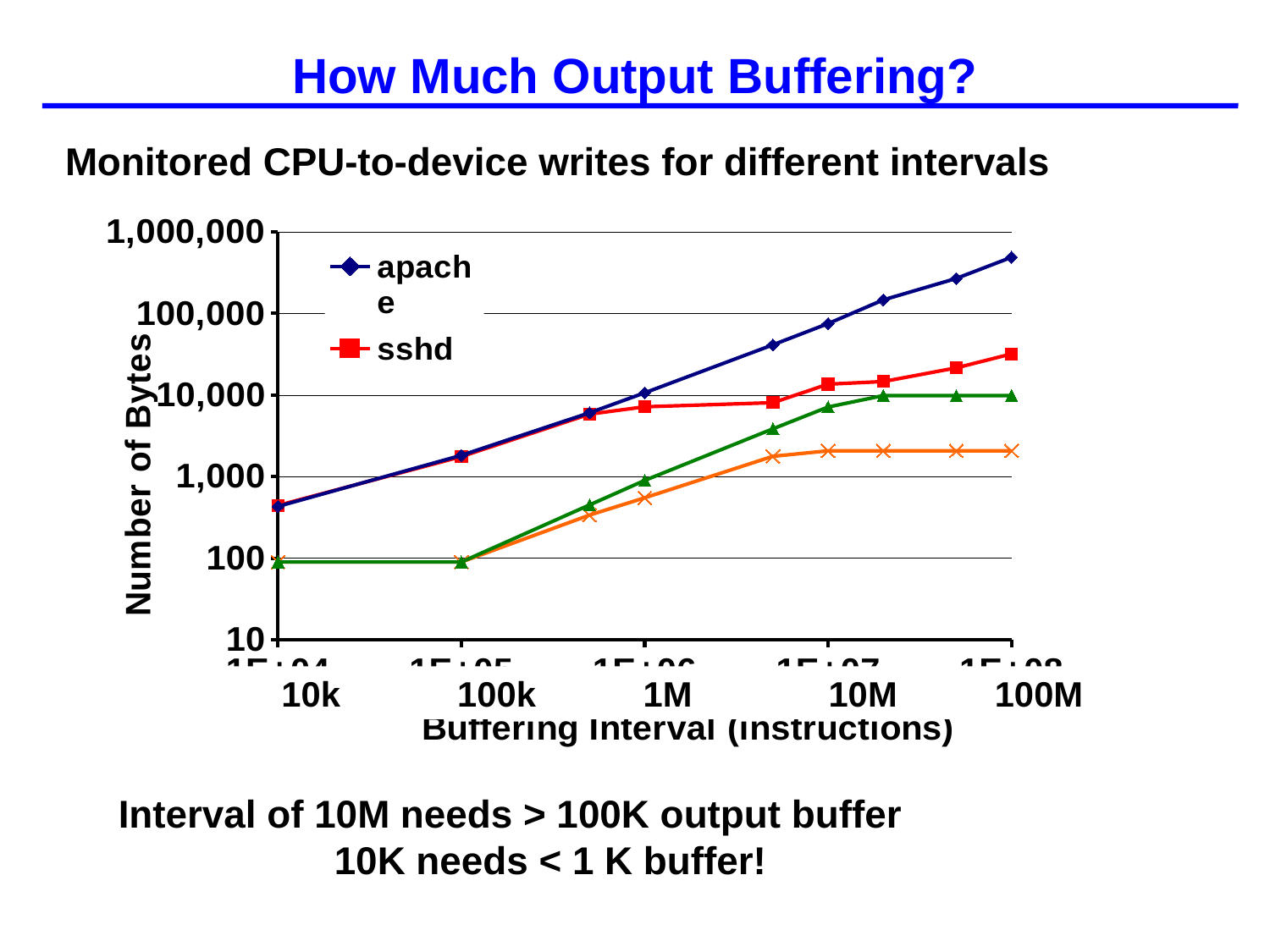
Which of the two legend series reaches the highest number of bytes on the chart? apache Is the value for sshd at a buffering interval of 100k greater or less than 1,000? greater Is the value for apache at a buffering interval of 10k greater or less than 1,000? less What is the label of the chart's y axis? Number of Bytes Is the value for sshd at a buffering interval of 1M greater or less than 10,000? less What kind of chart is shown on the slide? line chart What is the label of the chart's x axis? Buffering Interval (Instructions) How many series does the chart's legend list? 2 Which series is higher at a buffering interval of 100M, apache or sshd? apache Does the apache series rise or fall as the buffering interval increases? rise